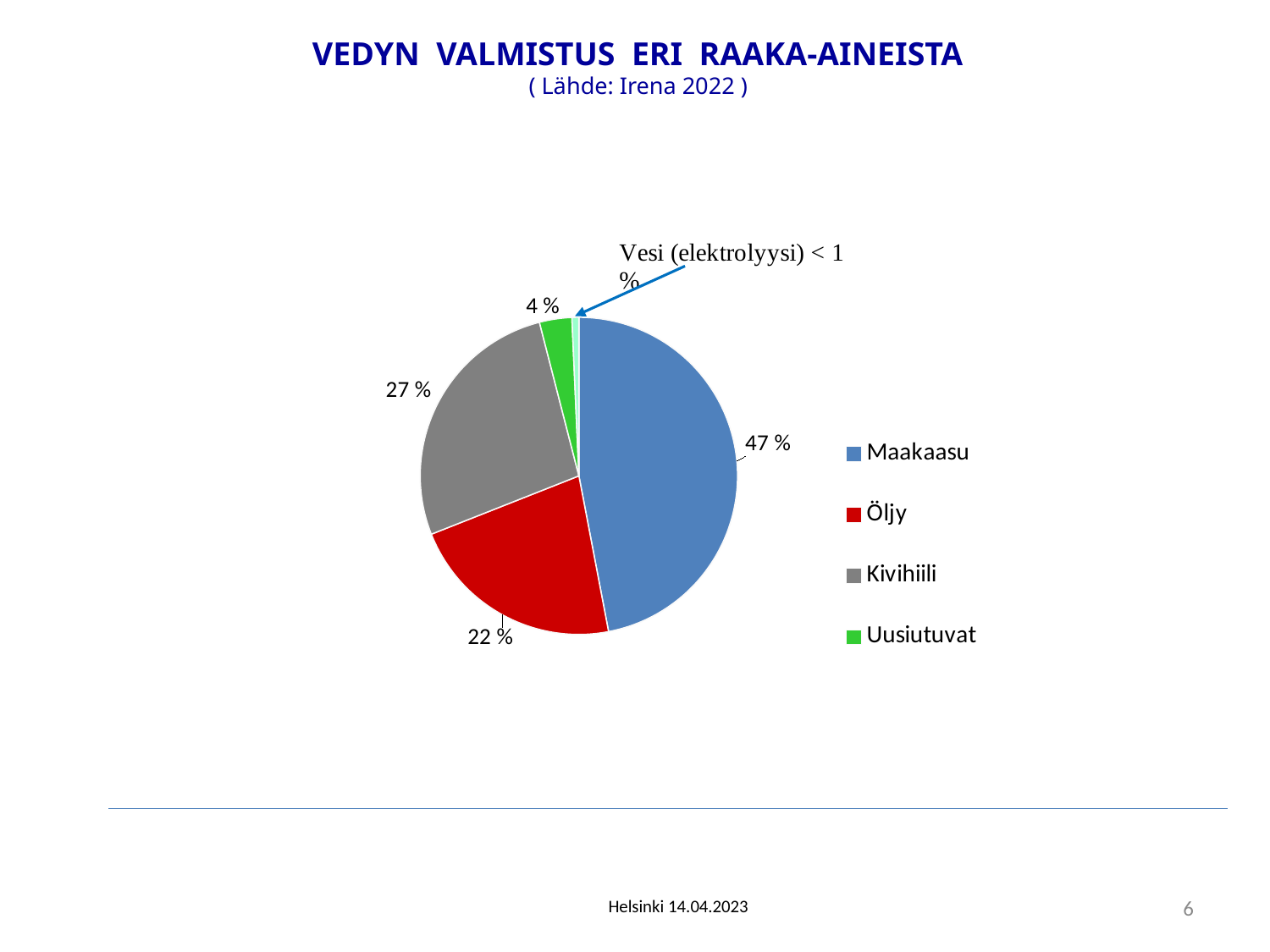
What colour is the Öljy slice in the pie chart? red What share of the pie does Öljy have? 22 % What share of the pie does Maakaasu have? 47 % What kind of chart is shown on the slide? pie chart Which of the legend categories has the smallest slice of the pie? Uusiutuvat What is the difference in percentage points between the Maakaasu slice and the Kivihiili slice? 20 % What share of the pie does Kivihiili have? 27 % What is the title of the chart on the slide? VEDYN VALMISTUS ERI RAAKA-AINEISTA Which is larger, the slice for Kivihiili or the slice for Öljy? Kivihiili Which category has the largest slice of the pie? Maakaasu How many entries does the legend list? 4